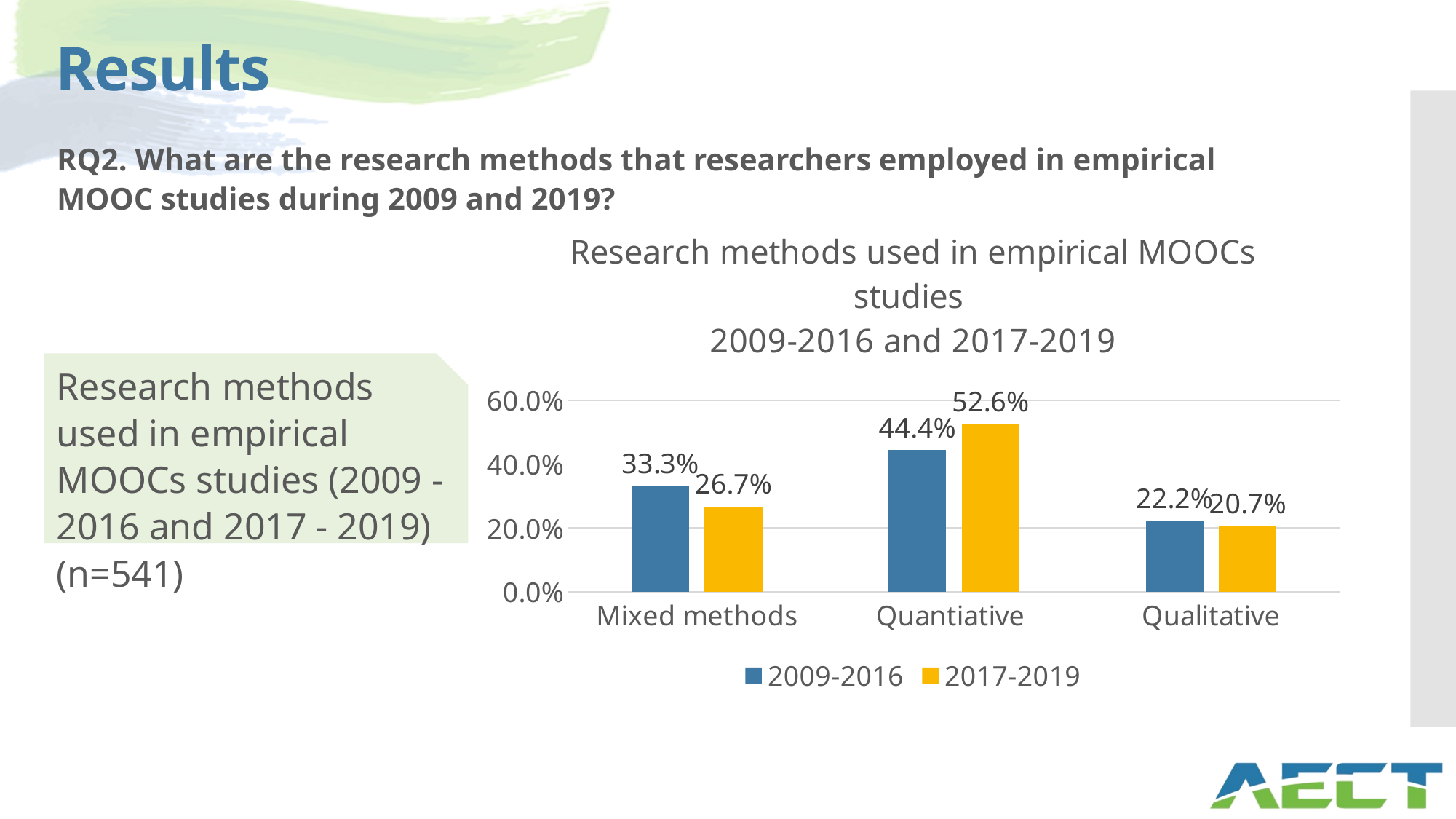
What is the difference between the 2017-2019 and 2009-2016 values for Quantiative? 8.2% Is the value for Quantiative in the 2017-2019 series greater or less than 40.0%? greater How many series does the legend list? 2 How many categories are shown on the x axis? 3 Which category has the lowest value in the 2009-2016 series? Qualitative What is the value for Mixed methods in the 2009-2016 series? 33.3% Which is larger for Mixed methods: the 2009-2016 value or the 2017-2019 value? 2009-2016 What kind of chart is shown on the slide? bar chart What is the value for Qualitative in the 2009-2016 series? 22.2% Which category has the highest value in the 2017-2019 series? Quantiative Which colour represents the 2017-2019 series in the legend? yellow What is the value for Quantiative in the 2017-2019 series? 52.6%